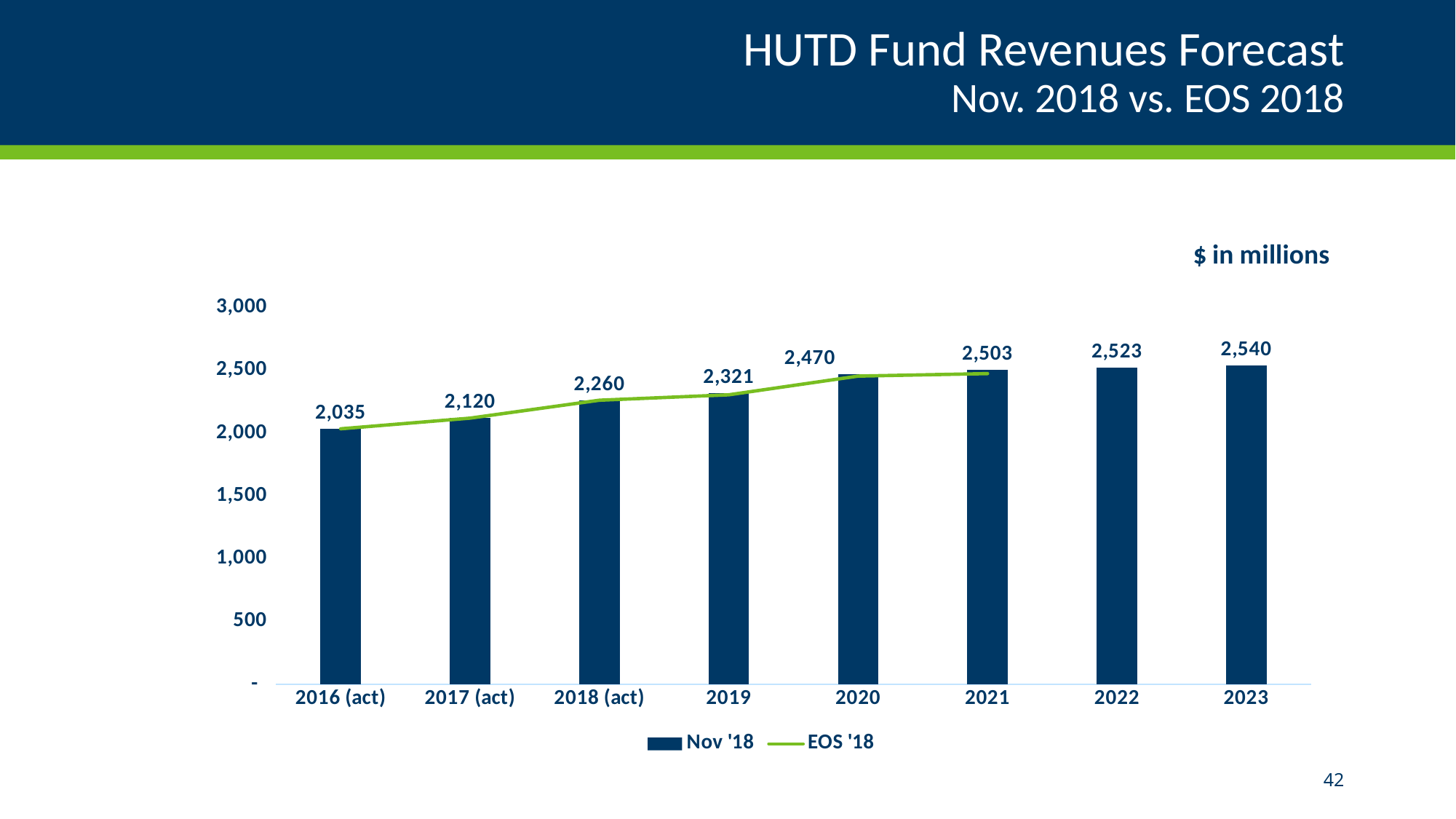
What is the Nov '18 value for 2016 (act)? 2,035 Which year has the lowest Nov '18 value? 2016 (act) Do the Nov '18 values rise or fall from 2016 (act) to 2023? rise What is the difference between the Nov '18 values for 2020 and 2019? 149 How many years are shown on the x axis? 8 What is the Nov '18 value for 2019? 2,321 Which year has the highest Nov '18 value? 2023 Which is larger, the Nov '18 value for 2018 (act) or for 2017 (act)? 2018 (act) How many series does the legend list? 2 Is the EOS '18 line value for 2016 (act) greater or less than 2,500? less What is the difference between the Nov '18 values for 2023 and 2016 (act)? 505 What is the Nov '18 value for 2022? 2,523